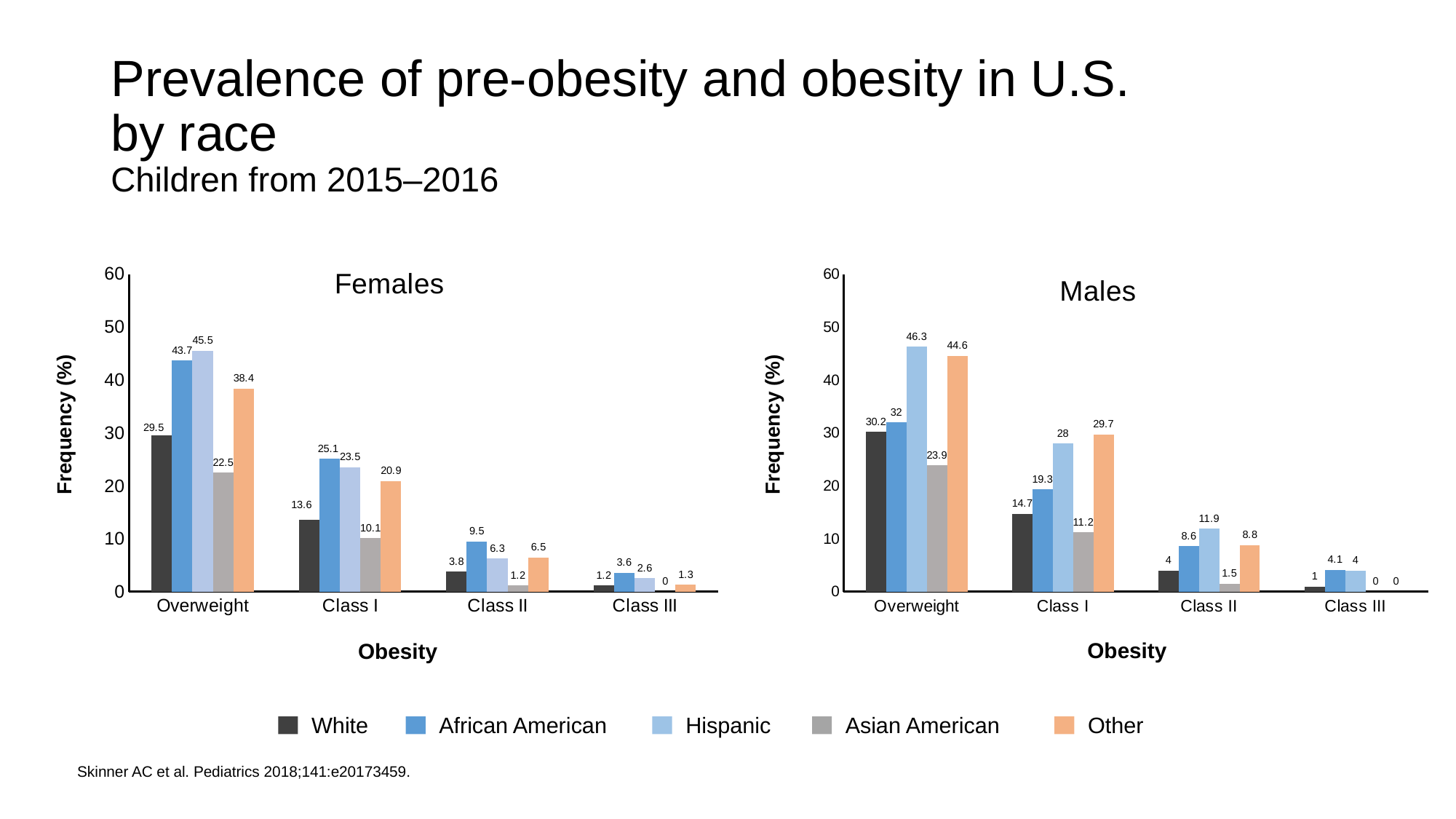
In the Females chart, what is the Overweight value for Hispanic? 45.5 In the Females chart, which race has the highest Overweight value? Hispanic In the Males chart, which race has the lowest Class II value? Asian American In the Females chart, which is larger: the Class I value for African American or for Hispanic? African American How many obesity categories are shown on the x axis of the Males chart? 4 In the Females chart, is the Overweight value for Other greater or less than 40? less In the Males chart, what is the difference between the Overweight values for Hispanic and White? 16.1 In the Males chart, what is the Class I value for African American? 19.3 What is the y-axis label of the Males chart? Frequency (%) In the Males chart, do the values for White rise or fall from Overweight to Class III? fall How many series does the legend list? 5 What kind of chart is the Females chart? bar chart